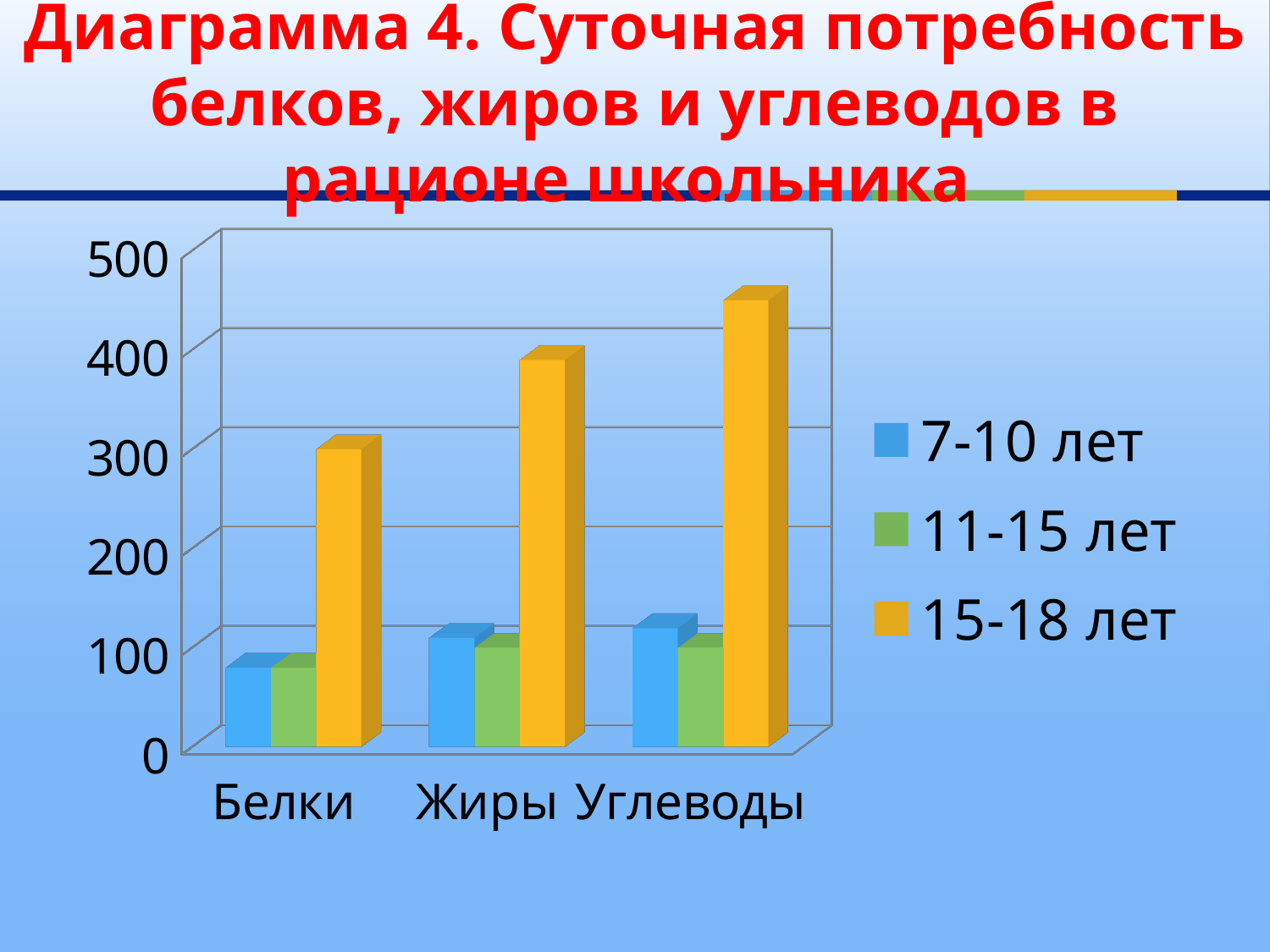
What kind of chart is shown on the slide? bar chart Is the value for Жиры in the 15-18 лет series greater or less than 300? greater Do the values for the 15-18 лет series rise or fall from Белки to Углеводы? rise Which is larger for Углеводы: the 15-18 лет value or the 7-10 лет value? 15-18 лет How many series does the chart legend list? 3 Is the value for Белки in the 7-10 лет series greater or less than 100? less Which category has the highest value for the 15-18 лет series? Углеводы How many categories are shown on the x axis of the chart? 3 Which category has the lowest value for the 15-18 лет series? Белки Which colour represents the 15-18 лет series in the chart? yellow Is the value for Углеводы in the 15-18 лет series greater or less than 400? greater